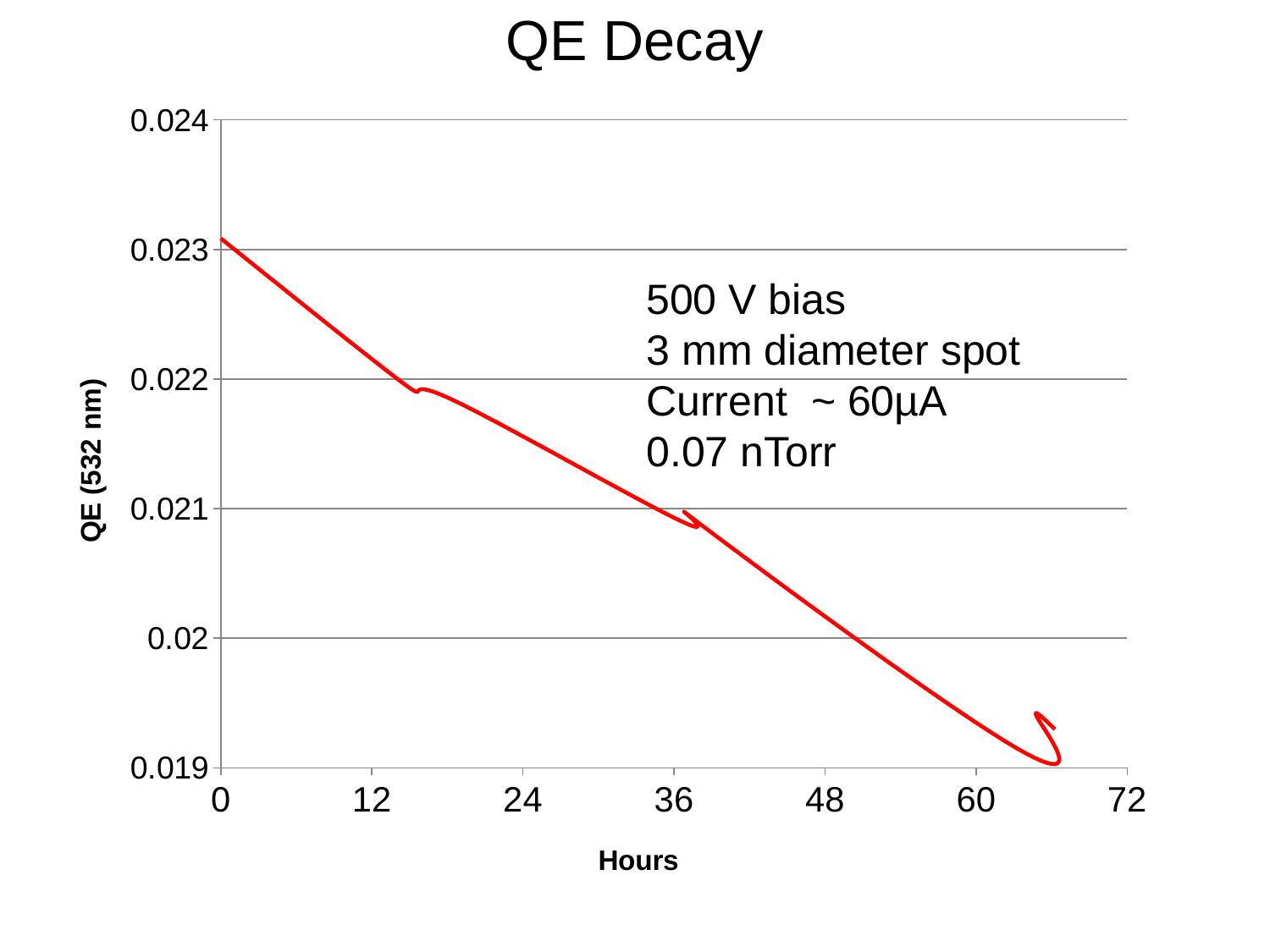
Does the QE value rise or fall as the hours increase along the x axis? fall Is the QE value at 42 hours greater or less than 0.021? less What is the title of the chart? QE Decay Is the QE value at 60 hours greater or less than 0.02? less Is the QE value at 24 hours greater or less than 0.021? greater What is the label of the y axis? QE (532 nm) What kind of chart is shown on the slide? line chart